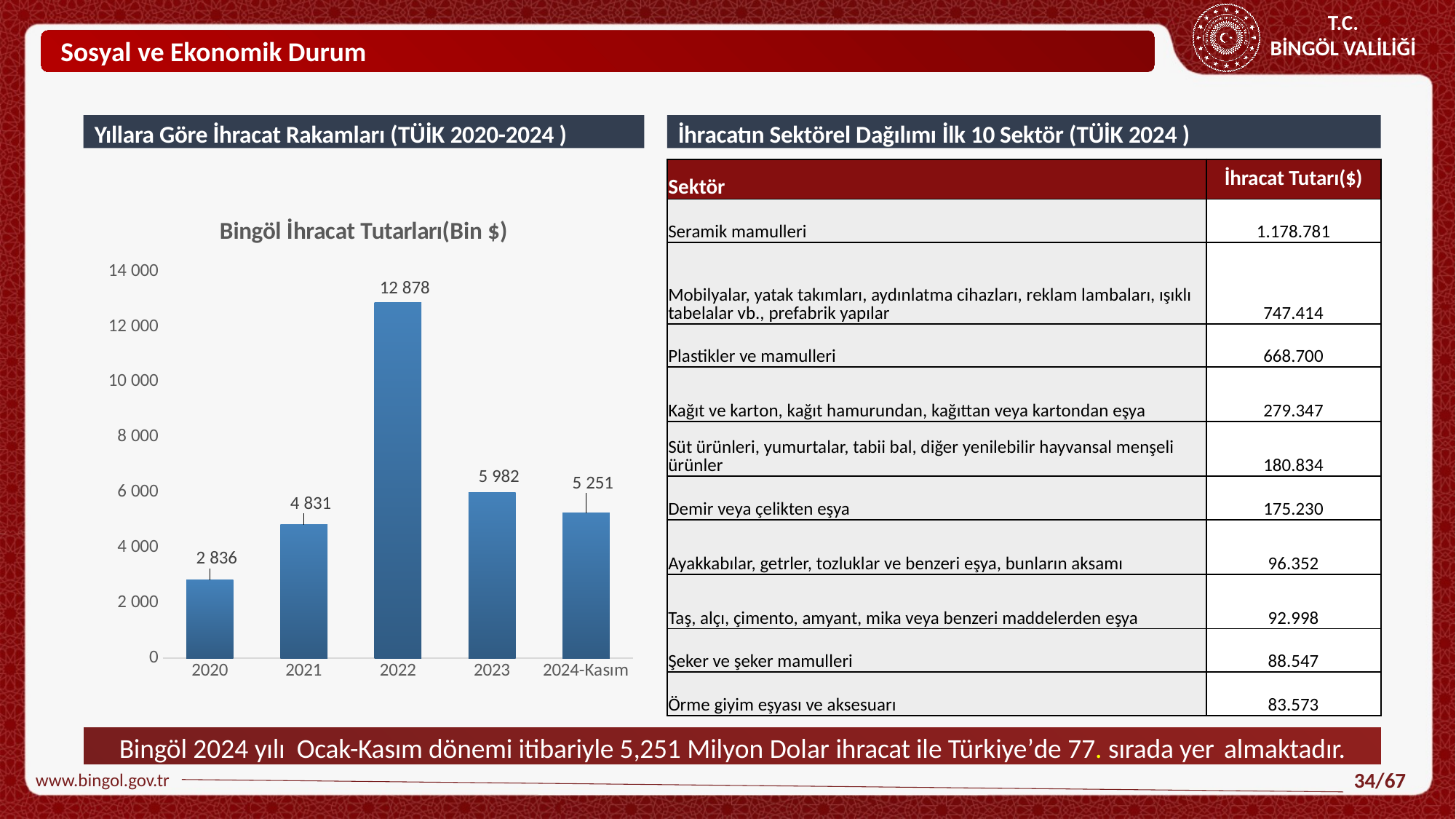
In the Bingöl İhracat Tutarları(Bin $) chart, which is larger: the value for 2023 or the value for 2024-Kasım? 2023 What is the value for 2020 in the Bingöl İhracat Tutarları(Bin $) chart? 2 836 What is the difference between the values for 2021 and 2020 in the Bingöl İhracat Tutarları(Bin $) chart? 1 995 How many bars are shown in the Bingöl İhracat Tutarları(Bin $) chart? 5 Which year has the highest value in the Bingöl İhracat Tutarları(Bin $) chart? 2022 Which year has the lowest value in the Bingöl İhracat Tutarları(Bin $) chart? 2020 What kind of chart is the Bingöl İhracat Tutarları(Bin $) chart? bar chart What is the value for 2022 in the Bingöl İhracat Tutarları(Bin $) chart? 12 878 Is the value for 2021 in the Bingöl İhracat Tutarları(Bin $) chart greater or less than 4 000? greater What is the difference between the values for 2022 and 2023 in the Bingöl İhracat Tutarları(Bin $) chart? 6 896 What is the value for 2024-Kasım in the Bingöl İhracat Tutarları(Bin $) chart? 5 251 What is the title of the chart on the left side of the slide? Bingöl İhracat Tutarları(Bin $)